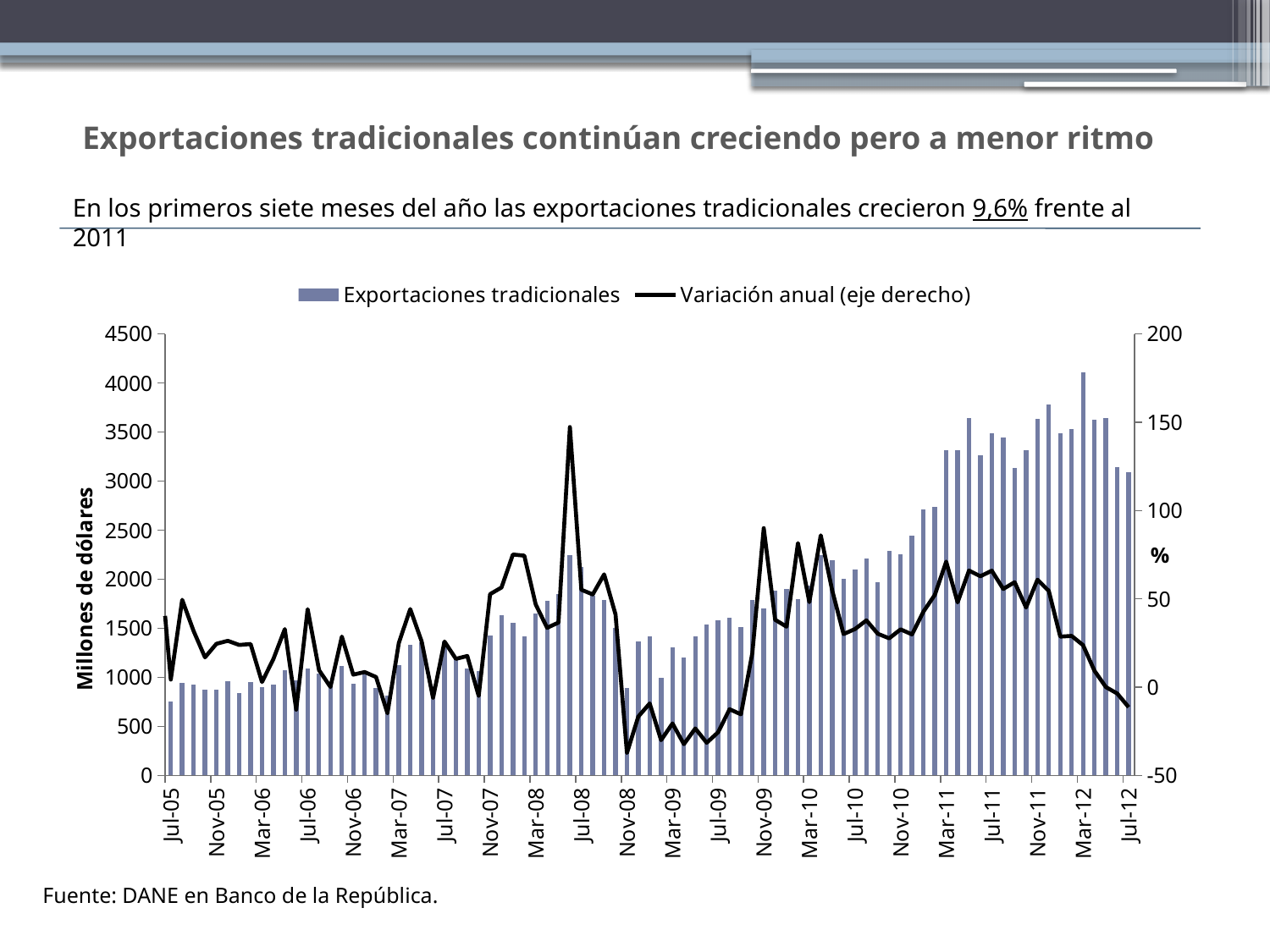
Is the value of the Exportaciones tradicionales bar for Jul-05 greater or less than 1000? less Overall, do the Exportaciones tradicionales bars rise or fall from Jul-05 to Jul-12? rise Is the value of the Exportaciones tradicionales bar for Nov-08 greater or less than 1000? less Which month has the highest Exportaciones tradicionales bar? Mar-12 Is the value of the Exportaciones tradicionales bar for Jul-11 greater or less than 3000? greater How many series does the chart legend list? 2 What kind of chart is shown on the slide? A combined bar and line chart Which series is plotted on the right axis according to the legend? Variación anual (eje derecho) What is the title of the left vertical axis? Millones de dólares